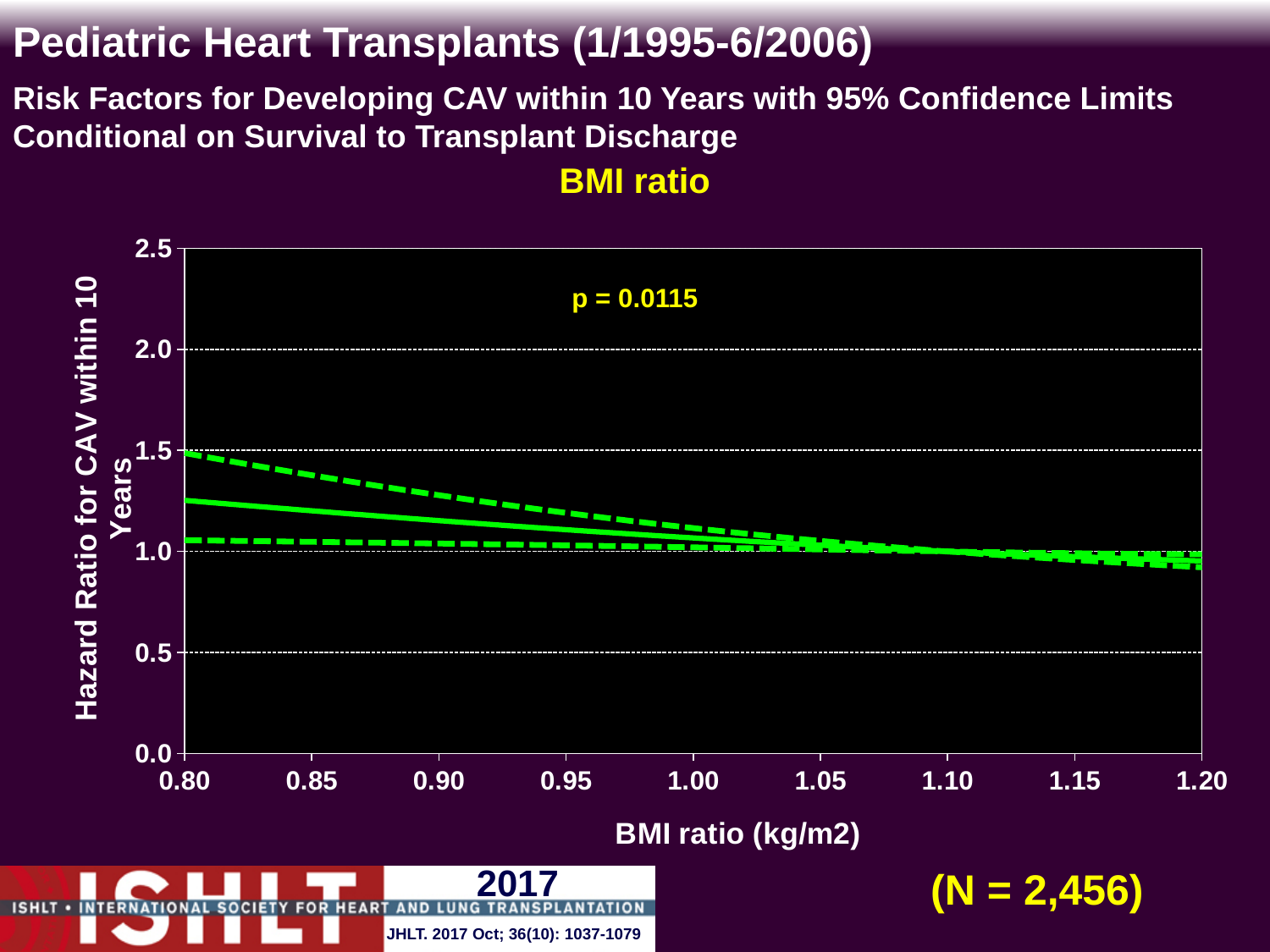
Does the solid hazard ratio line rise or fall as the BMI ratio increases from 0.80 to 1.20? fall How many tick labels are shown on the x axis? 9 How many lines are plotted on the chart? 3 Is the value of the solid hazard ratio line at a BMI ratio of 0.80 greater or less than 2.0? less What p-value is printed on the chart? p = 0.0115 Is the value of the solid hazard ratio line at a BMI ratio of 0.80 greater or less than 1.5? less Is the value of the lower dashed confidence limit at a BMI ratio of 0.80 greater or less than 1.5? less Is the solid hazard ratio line higher at a BMI ratio of 0.80 or at 1.20? 0.80 What sample size (N) is shown on the slide? N = 2,456 What kind of chart is shown on the slide? line chart